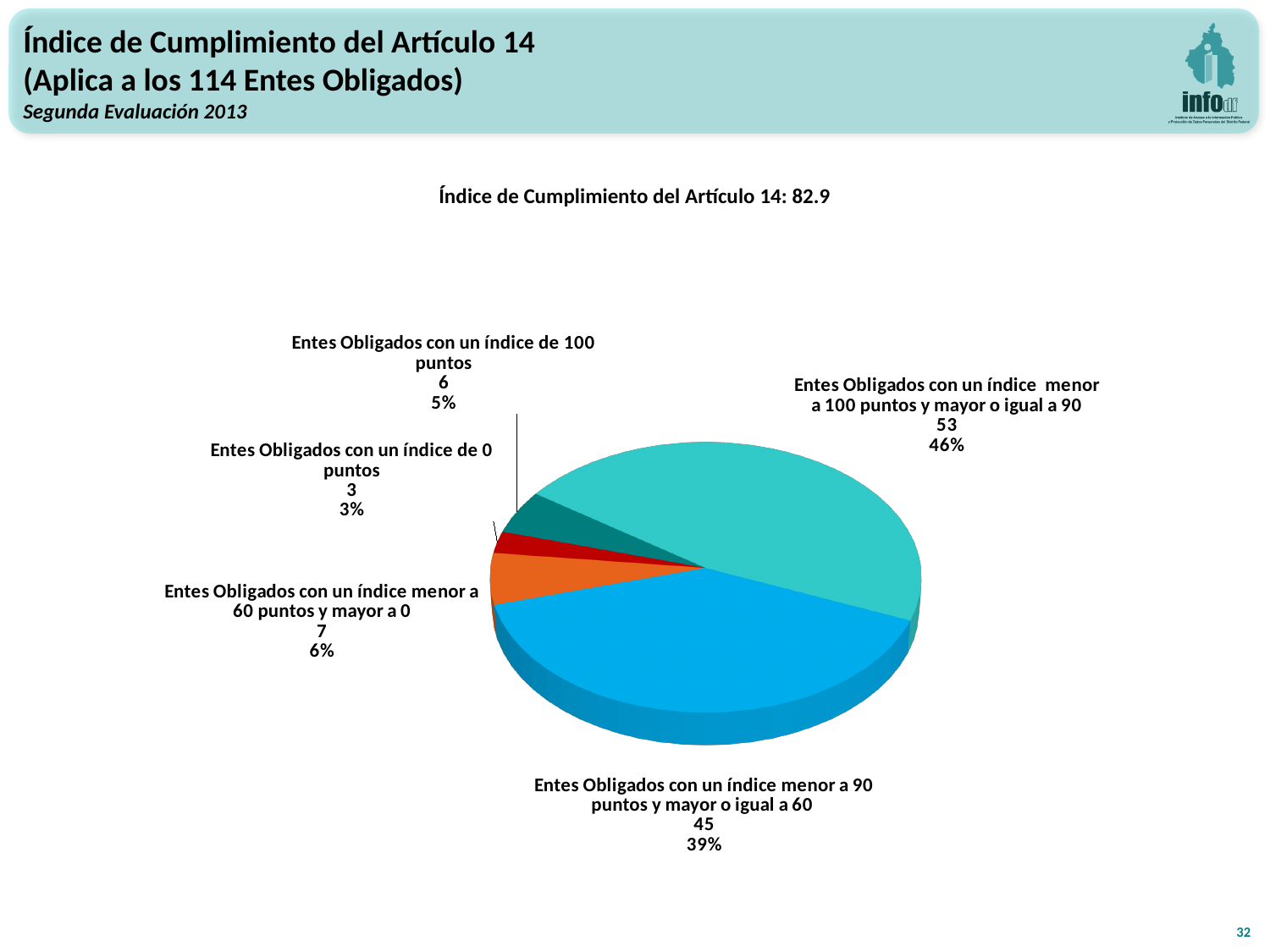
What is the difference in count between Entes Obligados with an index lower than 100 and greater than or equal to 90 and those with an index lower than 90 and greater than or equal to 60? 8 Which category has the largest slice of the pie? Entes Obligados con un índice menor a 100 puntos y mayor o igual a 90 How many Entes Obligados have an index of 100 points? 6 What is the total number of Entes Obligados across all slices of the pie? 114 Which is larger: the number of Entes Obligados with an index of 100 points or the number with an index lower than 60 points and greater than 0? Entes Obligados con un índice menor a 60 puntos y mayor a 0 What share of the pie is for Entes Obligados with an index of 0 points? 3% Which category has the smallest slice of the pie? Entes Obligados con un índice de 0 puntos How many Entes Obligados have an index lower than 100 points and greater than or equal to 90? 53 How many slices does the pie chart have? 5 What kind of chart is shown on the slide? pie chart What percentage of the pie corresponds to Entes Obligados with an index lower than 90 points and greater than or equal to 60? 39% What is the Índice de Cumplimiento del Artículo 14 value stated above the chart? 82.9